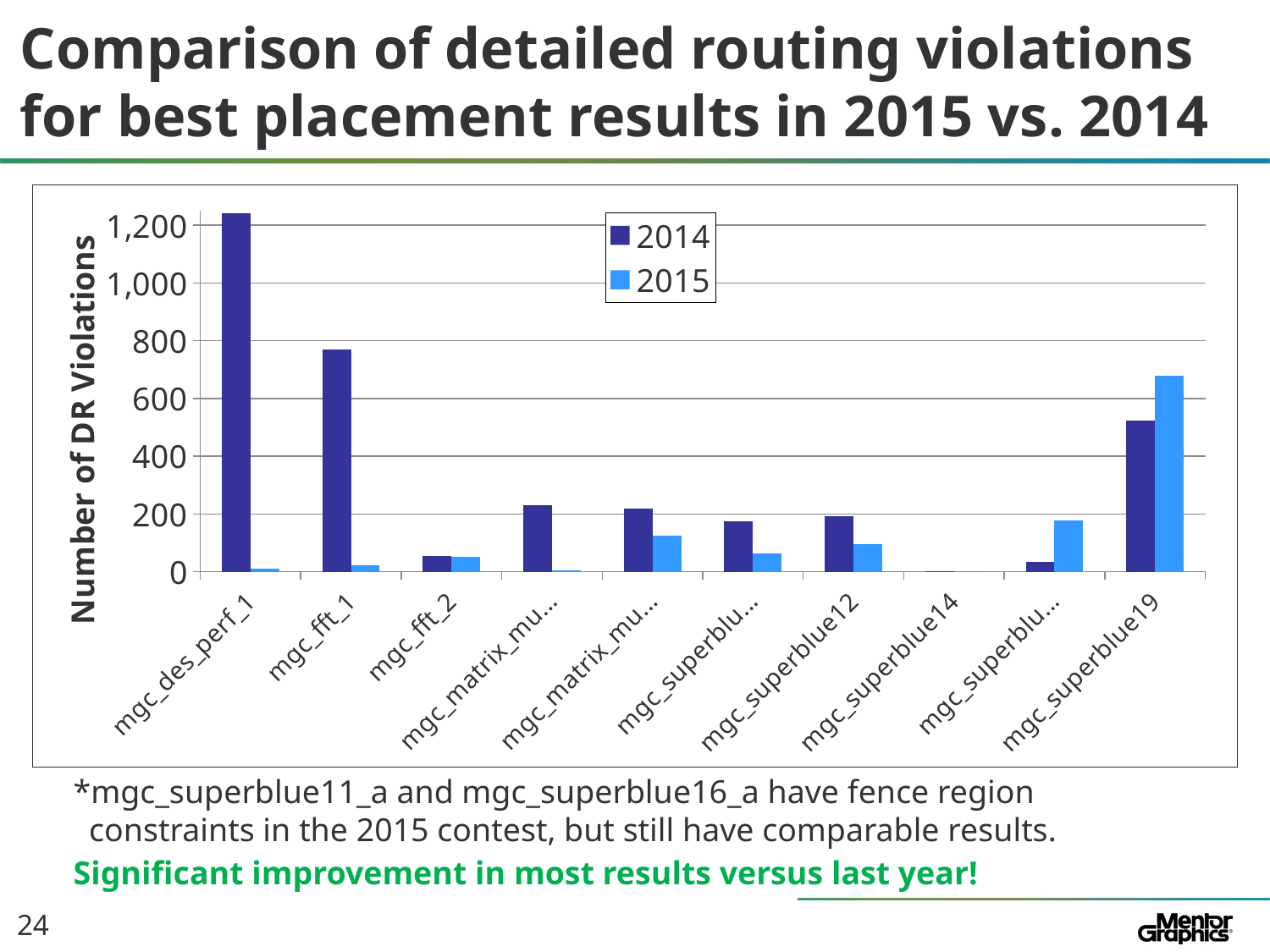
How many benchmark categories are plotted along the x axis? 10 Is the 2014 value for mgc_des_perf_1 greater or less than 1,000? greater Is the 2015 value for mgc_superblue19 greater or less than 600? greater For mgc_superblue19, which series has the larger value, 2014 or 2015? 2015 What is the title of the y axis? Number of DR Violations Is the 2014 value for mgc_fft_1 greater or less than 800? less What kind of chart is shown on the slide? bar chart Which category has the highest 2014 value? mgc_des_perf_1 For mgc_superblue12, which series has the larger value, 2014 or 2015? 2014 Which category has the highest 2015 value? mgc_superblue19 Which series is shown in dark blue according to the legend? 2014 How many series does the legend list? 2